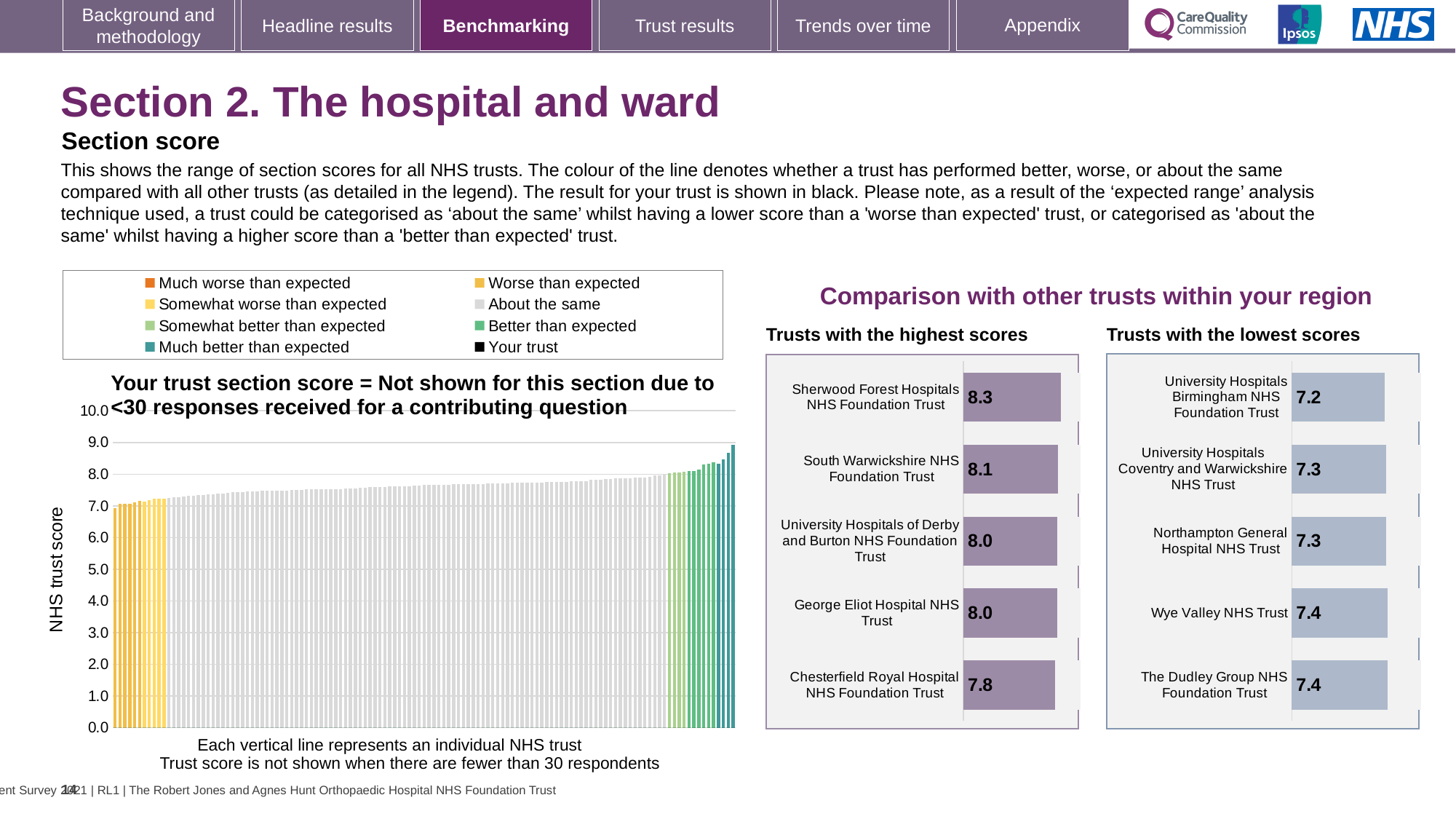
In the 'Trusts with the highest scores' chart, which trust has the highest score? Sherwood Forest Hospitals NHS Foundation Trust In the 'Trusts with the lowest scores' chart, which trust has the lowest score? University Hospitals Birmingham NHS Foundation Trust In the large chart on the left, do the trust scores rise or fall from left to right along the x axis? Rise In the 'Trusts with the lowest scores' chart, what is the score for University Hospitals Birmingham NHS Foundation Trust? 7.2 In the 'Trusts with the highest scores' chart, what is the difference between the scores of Sherwood Forest Hospitals NHS Foundation Trust and Chesterfield Royal Hospital NHS Foundation Trust? 0.5 In the 'Trusts with the highest scores' chart, what is the score for Chesterfield Royal Hospital NHS Foundation Trust? 7.8 In the 'Trusts with the lowest scores' chart, which has the higher score: Northampton General Hospital NHS Trust or The Dudley Group NHS Foundation Trust? The Dudley Group NHS Foundation Trust In the 'Trusts with the highest scores' chart, what is the score for Sherwood Forest Hospitals NHS Foundation Trust? 8.3 How many trusts are shown in the 'Trusts with the highest scores' chart? 5 In the 'Trusts with the lowest scores' chart, what is the score for Wye Valley NHS Trust? 7.4 What type of chart is the large chart on the left showing the range of section scores for all NHS trusts? Bar chart What is the y-axis label of the large chart on the left? NHS trust score